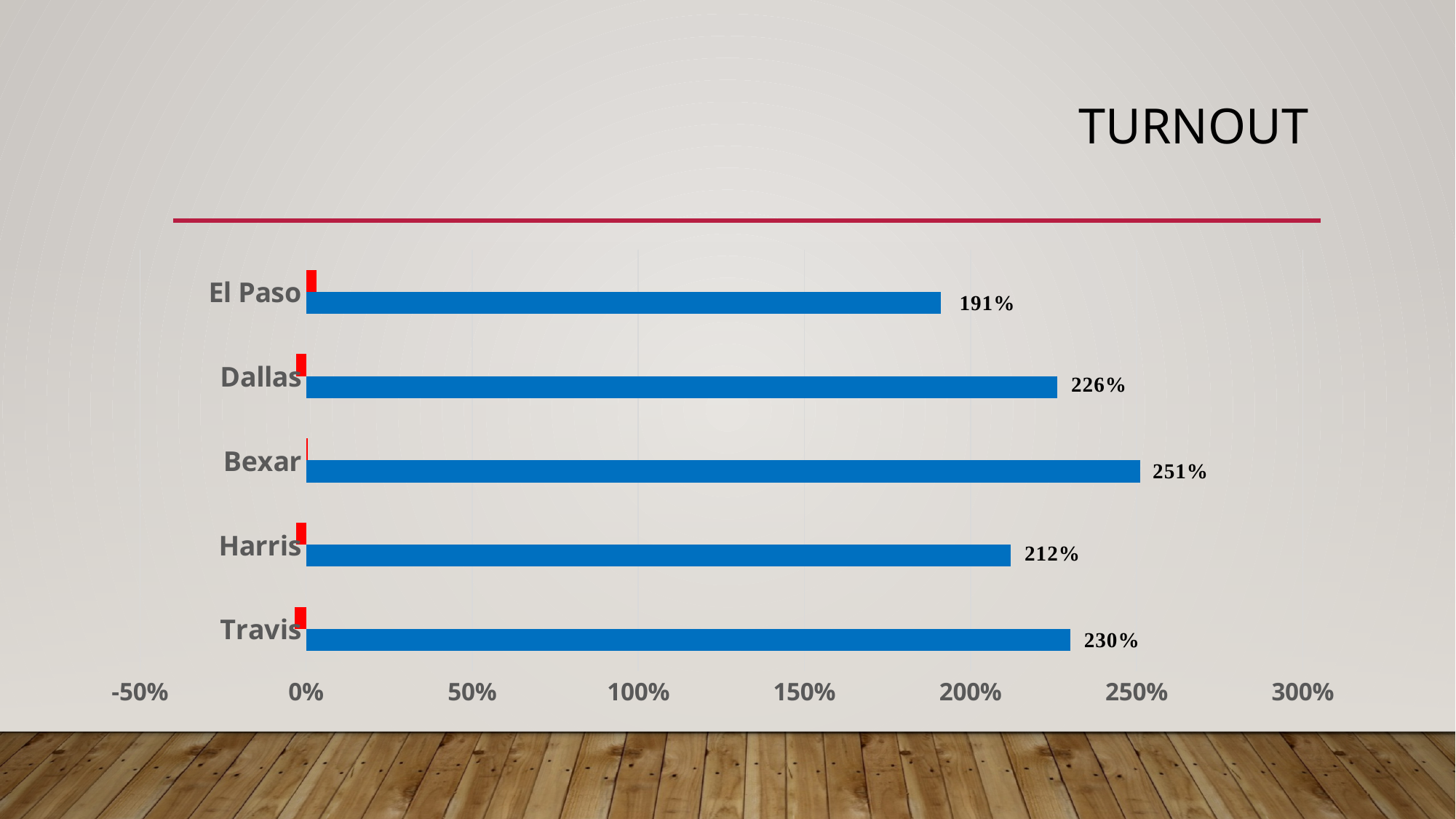
What is the difference between the turnout values for Travis and Harris? 18% Which county has the lowest turnout value? El Paso How many counties are shown on the chart? 5 What is the difference between the turnout values for Bexar and El Paso? 60% Is the turnout value for Harris greater or less than 200%? greater What is the title of the slide? TURNOUT What is the turnout value shown for Travis? 230% Which county has the highest turnout value? Bexar Which has a larger turnout value, Dallas or Harris? Dallas What is the turnout value shown for El Paso? 191% What kind of chart is shown on the slide? Bar chart What is the turnout value shown for Bexar? 251%